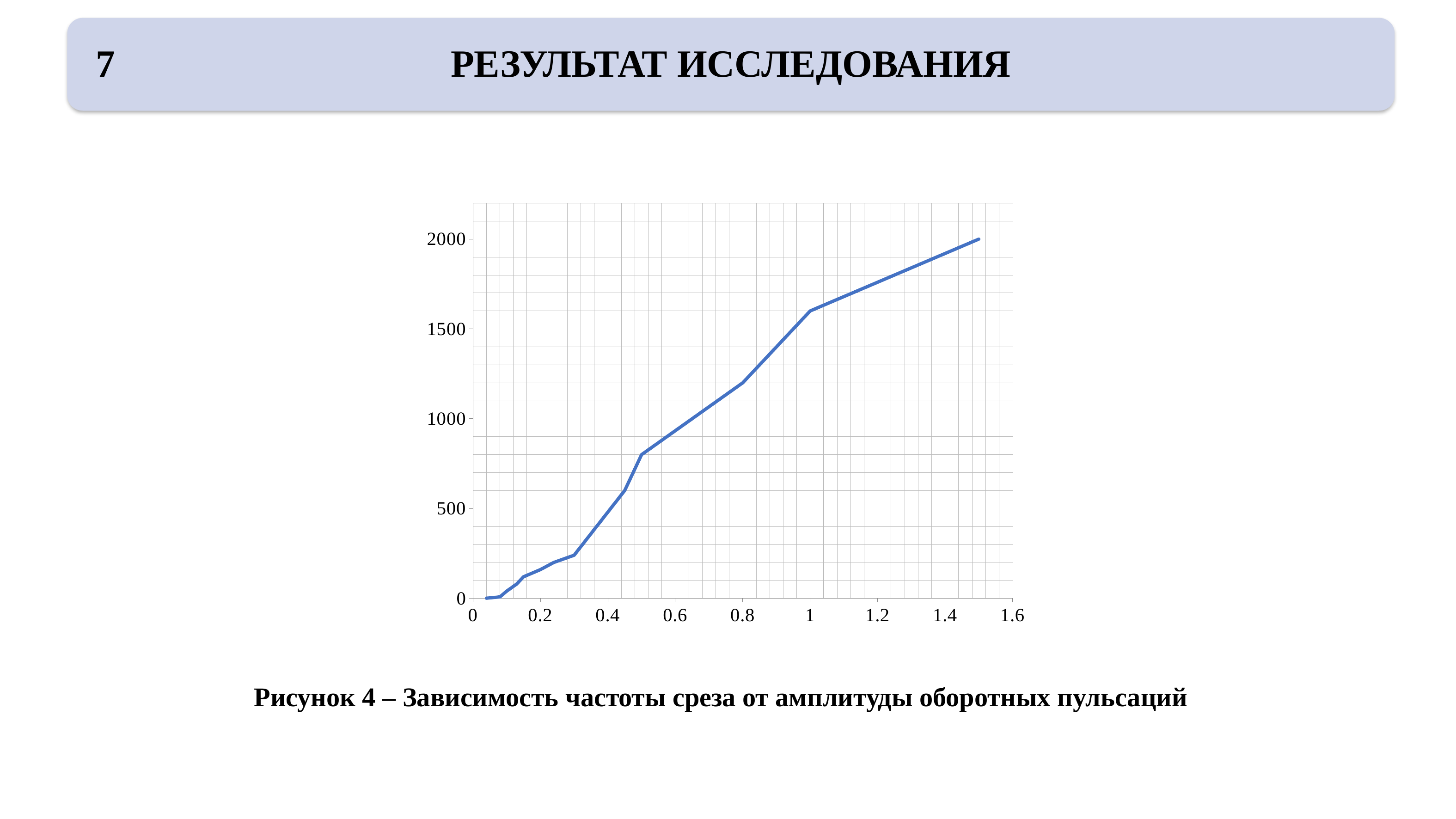
What kind of chart is shown on the slide? line chart What is the highest tick label shown on the y-axis? 2000 Is the value at x = 1.5 greater or less than 1500? greater What is the caption given for the chart below it? Рисунок 4 – Зависимость частоты среза от амплитуды оборотных пульсаций Is the value at x = 0.8 greater or less than 1000? greater Is the value at x = 1 greater or less than 1500? greater Do the values rise or fall as the x-axis value increases from 0 to 1.5? rise